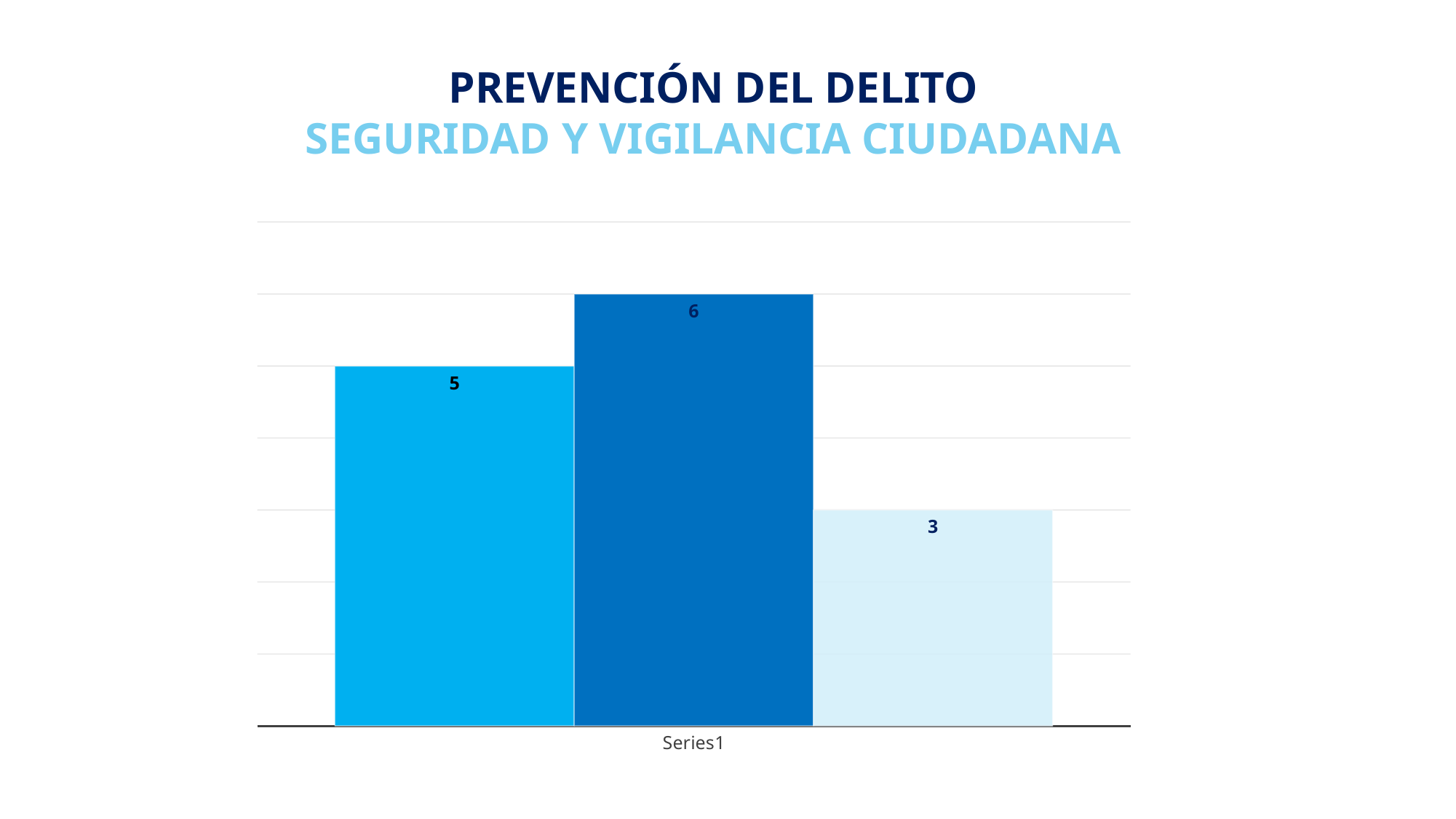
What is the difference between the middle bar's value and the leftmost bar's value? 1 What is the subtitle of the chart, shown in light blue text? SEGURIDAD Y VIGILANCIA CIUDADANA What is the value shown on the middle (dark blue) bar? 6 Which bar has the highest value: the left, middle, or right bar? middle What is the value shown on the rightmost (pale blue) bar? 3 What is the value shown on the leftmost bar? 5 How many bars are plotted in the chart? 3 What is the difference between the middle bar's value and the rightmost bar's value? 3 What type of chart is shown on the slide? bar chart Which bar has the lowest value: the left, middle, or right bar? right Which is larger, the value of the leftmost bar or the value of the rightmost bar? leftmost bar What is the category label shown on the x axis? Series1